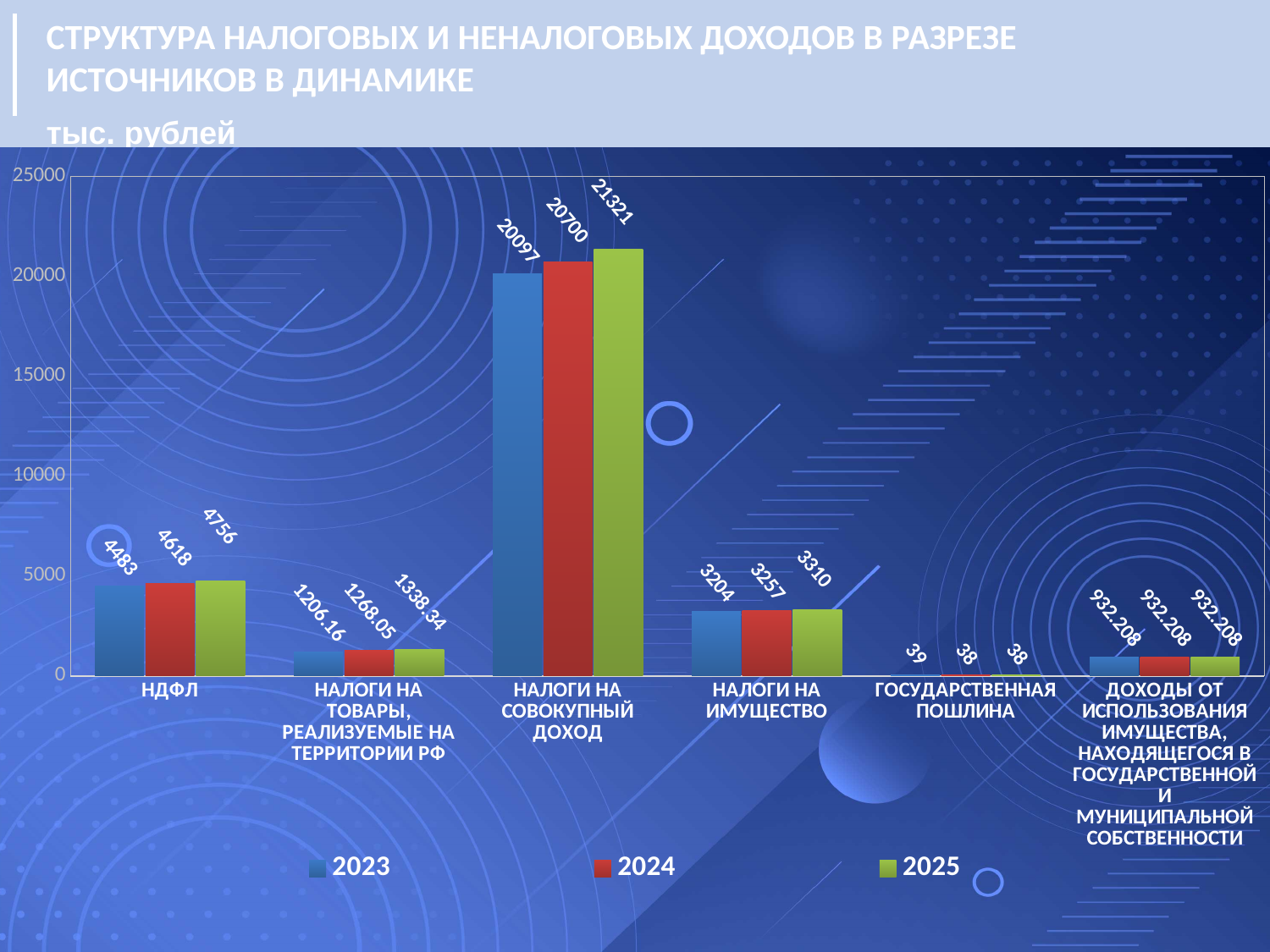
What is the value for НАЛОГИ НА СОВОКУПНЫЙ ДОХОД in 2023? 20097 What is the value for ГОСУДАРСТВЕННАЯ ПОШЛИНА in 2023? 39 Do the values for НАЛОГИ НА ИМУЩЕСТВО rise or fall from 2023 to 2025? Rise Which is larger: the 2024 value for НДФЛ or the 2024 value for НАЛОГИ НА ИМУЩЕСТВО? НДФЛ Which category has the highest value in 2025? НАЛОГИ НА СОВОКУПНЫЙ ДОХОД What is the value for НДФЛ in 2025? 4756 How many series does the legend list? 3 How many categories are shown on the x axis? 6 What is the difference between the 2025 and 2023 values for НАЛОГИ НА СОВОКУПНЫЙ ДОХОД? 1224 What kind of chart is shown on the slide? Bar chart Which category has the lowest value in 2024? ГОСУДАРСТВЕННАЯ ПОШЛИНА What is the value for НАЛОГИ НА ТОВАРЫ, РЕАЛИЗУЕМЫЕ НА ТЕРРИТОРИИ РФ in 2024? 1268.05